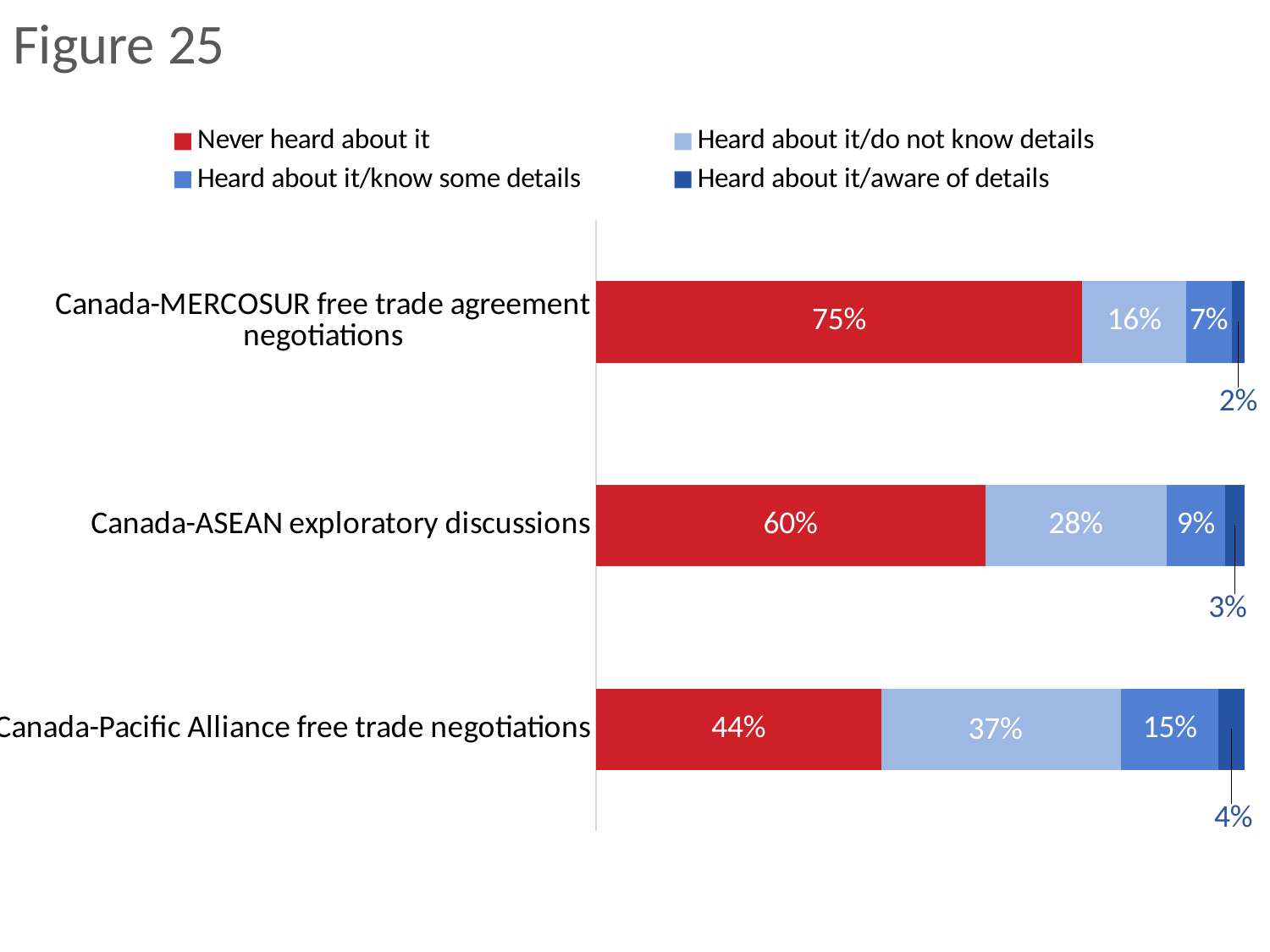
Which colour represents 'Never heard about it' in the legend? Red How many items (categories) are shown in the chart? 3 What is the difference between the 'Never heard about it' shares for Canada-MERCOSUR and Canada-Pacific Alliance? 31% How many series does the legend list? 4 What percentage of respondents had heard about the Canada-Pacific Alliance free trade negotiations and knew some details? 15% What percentage of respondents had heard about the Canada-ASEAN exploratory discussions but did not know details? 28% What percentage of respondents had never heard about the Canada-MERCOSUR free trade agreement negotiations? 75% Which item has the highest share of respondents who had never heard about it? Canada-MERCOSUR free trade agreement negotiations Which is larger: the 'Heard about it/do not know details' share for Canada-ASEAN or for Canada-Pacific Alliance? Canada-Pacific Alliance free trade negotiations What percentage of respondents were aware of details of the Canada-Pacific Alliance free trade negotiations? 4% What kind of chart is shown on the slide? Stacked bar chart Which item has the lowest share of respondents who were aware of details? Canada-MERCOSUR free trade agreement negotiations